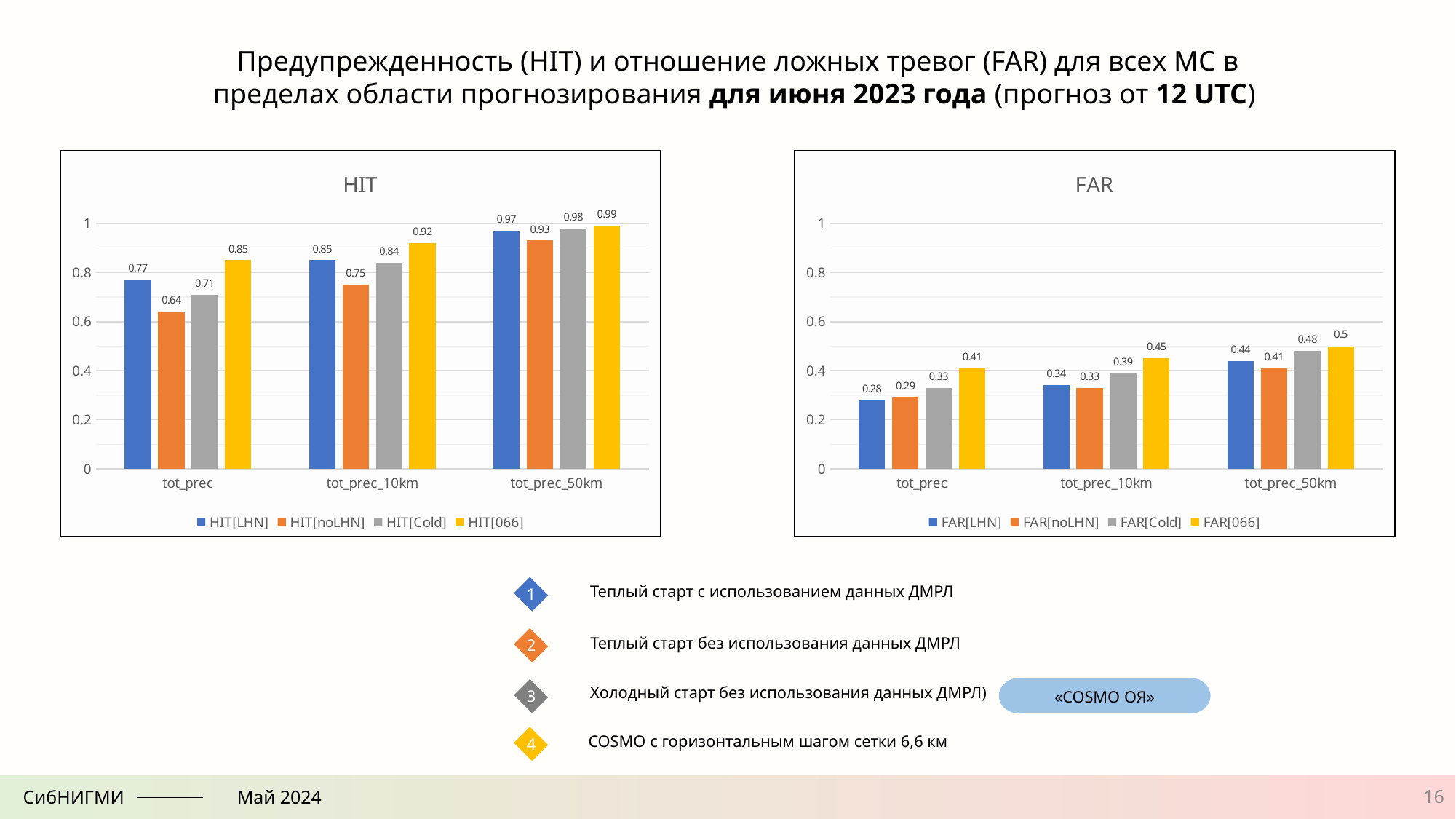
In the FAR chart, what is the value of FAR[Cold] for tot_prec_50km? 0.48 In the FAR chart, what is the difference between FAR[066] and FAR[LHN] for tot_prec_50km? 0.06 In the HIT chart, what is the difference between HIT[066] and HIT[LHN] for tot_prec? 0.08 In the HIT chart, what is the value of HIT[066] for tot_prec_10km? 0.92 How many categories are shown on the x axis of the HIT chart? 3 In the FAR chart, which series has the highest value for tot_prec_10km? FAR[066] In the HIT chart, which is larger for tot_prec_10km: HIT[LHN] or HIT[Cold]? HIT[LHN] In the FAR chart, what is the value of FAR[noLHN] for tot_prec? 0.29 In the HIT chart, what is the value of HIT[LHN] for tot_prec? 0.77 How many series does the legend of the FAR chart list? 4 In the HIT chart, do the HIT[LHN] values rise or fall from tot_prec to tot_prec_50km? rise In the HIT chart, which series has the lowest value for tot_prec? HIT[noLHN]